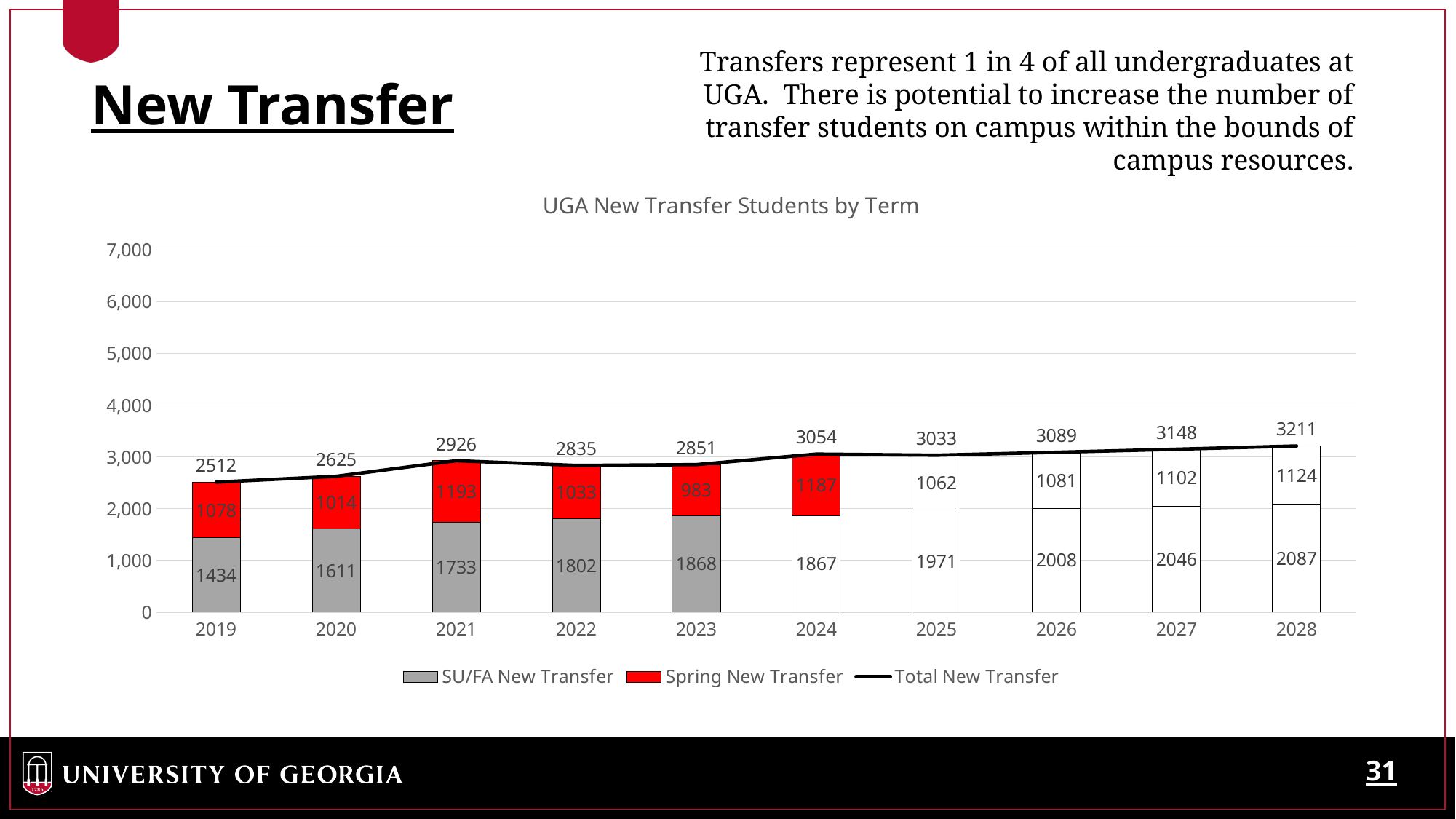
What is the difference between the Total New Transfer values for 2028 and 2019? 699 How many series does the legend list? 3 What is the Spring New Transfer value for 2021? 1193 What is the title of the chart? UGA New Transfer Students by Term What is the Total New Transfer value for 2024? 3054 Which year has the highest Total New Transfer value? 2028 Does the Total New Transfer line generally rise or fall from 2019 to 2028? rise Is the Total New Transfer value for 2021 greater or less than 2,000? greater Which year has the lowest SU/FA New Transfer value? 2019 Which is larger, the Spring New Transfer value for 2022 or for 2023? 2022 How many years are shown on the x axis? 10 What is the SU/FA New Transfer value for 2019? 1434